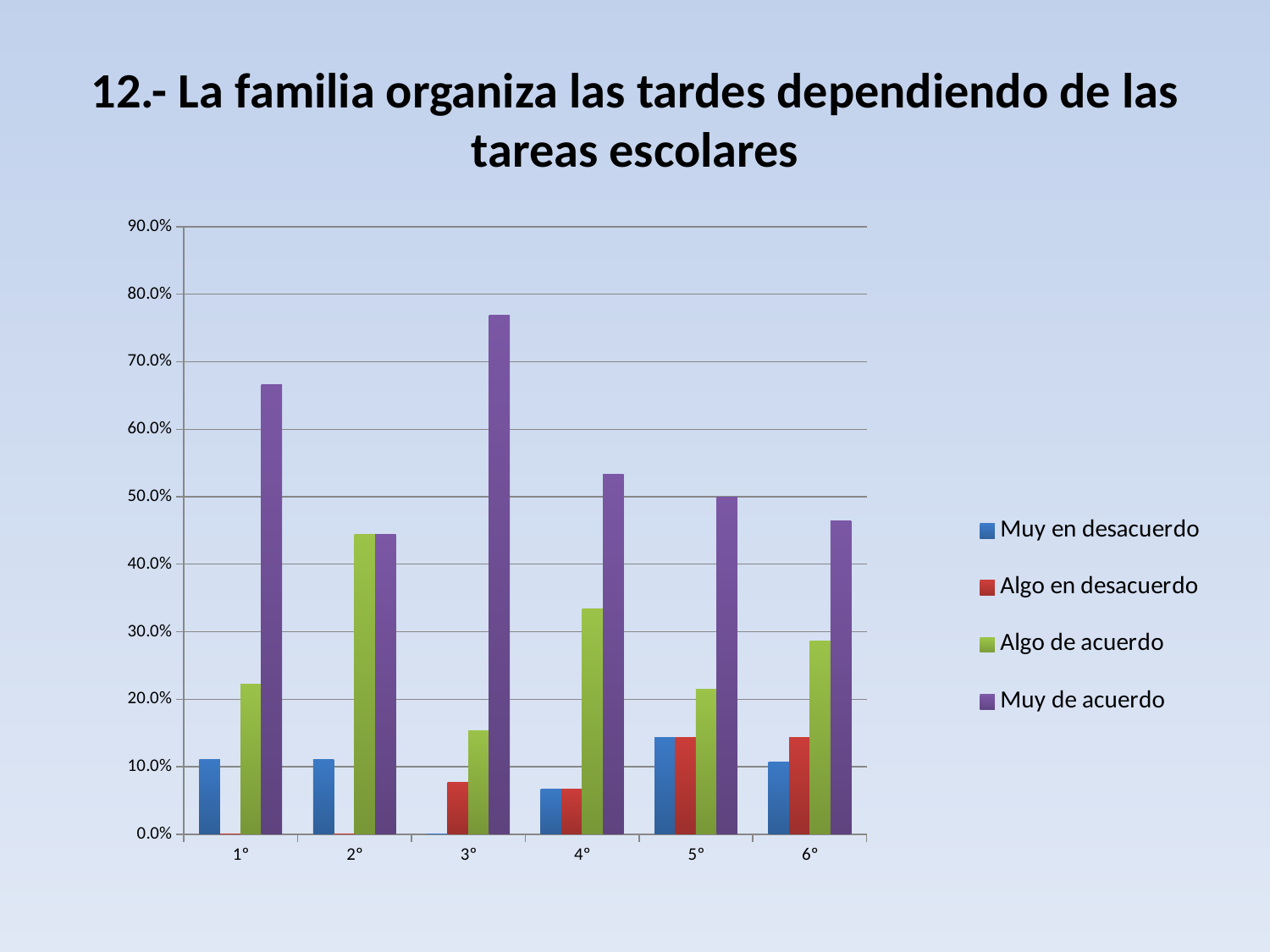
Is the value for Muy de acuerdo in 3° greater or less than 70%? greater What colour represents the Muy de acuerdo series in the legend? Purple Which is larger: Muy de acuerdo in 1° or Muy de acuerdo in 4°? 1° Which grade has the highest value for Muy de acuerdo? 3° Is the value for Algo de acuerdo in 6° greater or less than 20%? greater How many grade categories are shown on the x axis? 6 How many series does the legend list? 4 Is the value for Muy en desacuerdo in 5° greater or less than 10%? greater In 4°, which is larger: Algo de acuerdo or Muy de acuerdo? Muy de acuerdo What kind of chart is shown on the slide? Bar chart